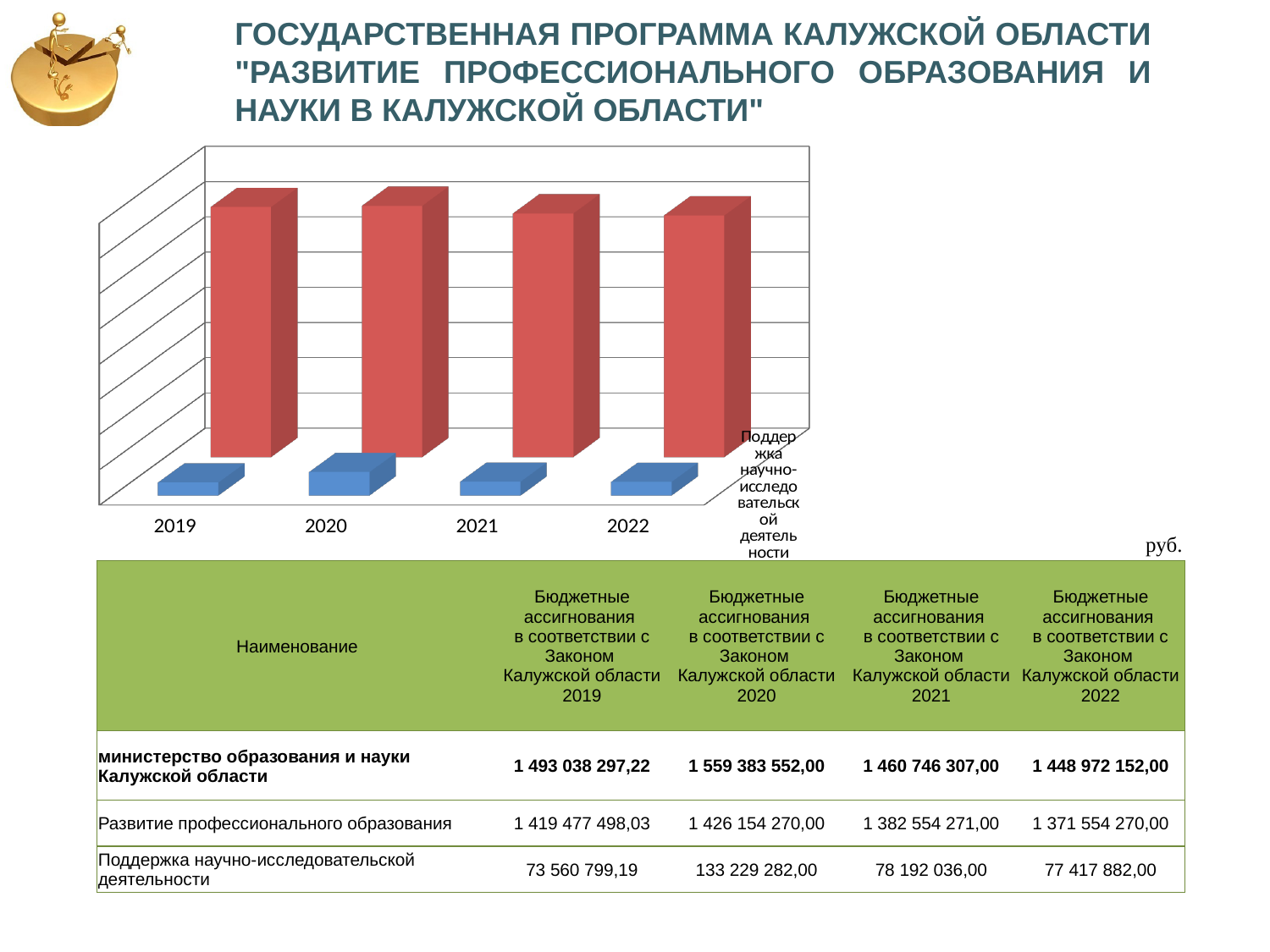
Which is larger in 2019: the red bar or the blue bar? the red bar Which is larger for Поддержка научно-исследовательской деятельности: 2020 or 2021? 2020 Do the red bars rise or fall from 2020 to 2022? fall According to the table below the chart, what is the value for Поддержка научно-исследовательской деятельности in 2020? 133 229 282,00 How many years are shown along the x axis of the chart? 4 Using the table values, by how much did Поддержка научно-исследовательской деятельности increase from 2019 to 2020? 59 668 482,81 Which years are shown along the x axis of the chart? 2019, 2020, 2021, 2022 In which year is the blue bar (Поддержка научно-исследовательской деятельности) the tallest? 2020 Do the blue bars rise or fall from 2020 to 2022? fall How many series of bars are plotted in the chart? 2 What kind of chart is shown on the slide? bar chart According to the table below the chart, what is the value for Развитие профессионального образования in 2022? 1 371 554 270,00